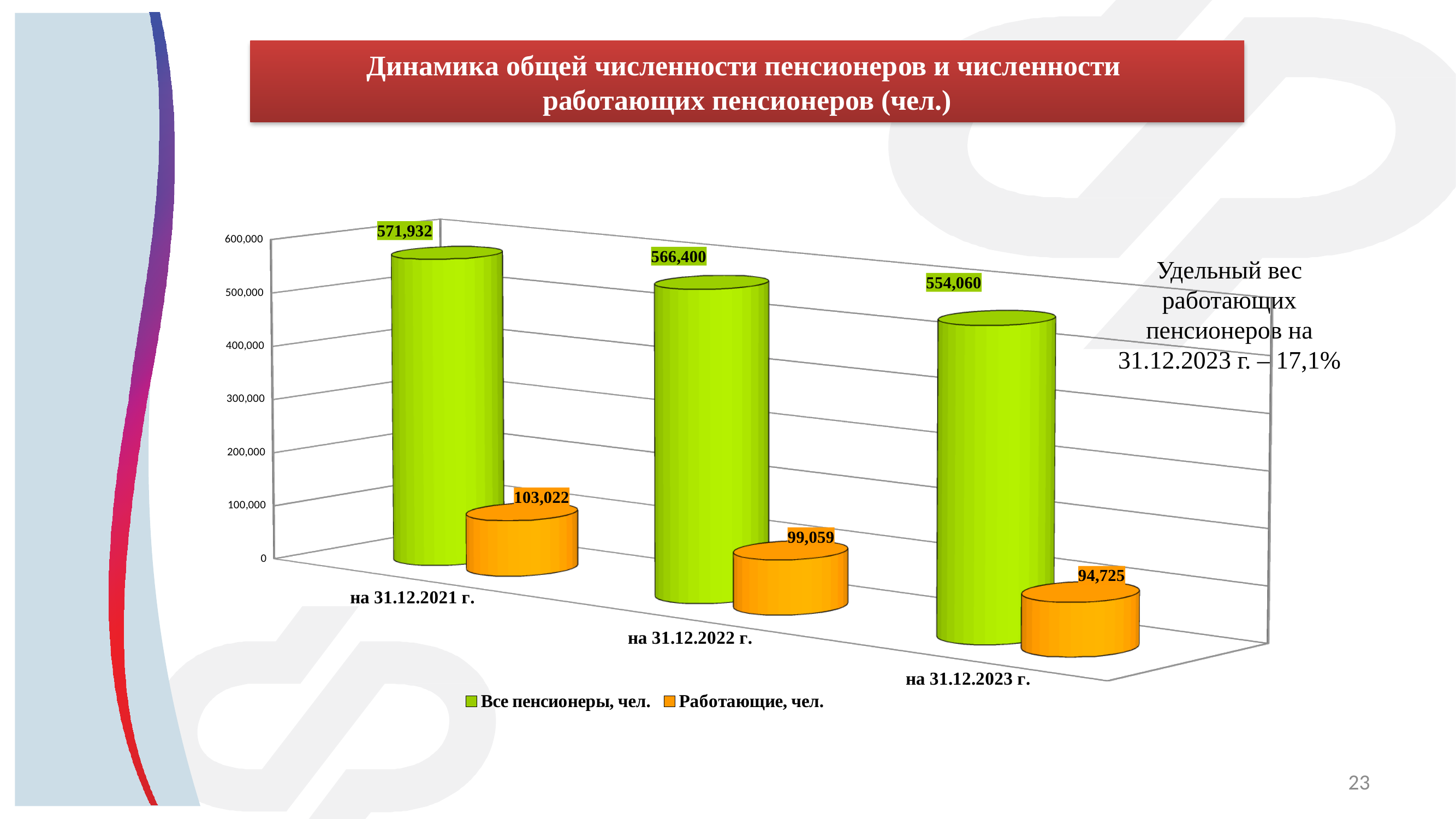
Do the values for 'Все пенсионеры, чел.' rise or fall from 31.12.2021 to 31.12.2023? fall What is the value for 'Все пенсионеры, чел.' on 31.12.2022? 566,400 What is the difference between 'Работающие, чел.' on 31.12.2021 and on 31.12.2022? 3,963 What is the value for 'Работающие, чел.' on 31.12.2023? 94,725 How many series does the legend list? 2 In which period is the value for 'Все пенсионеры, чел.' the highest? на 31.12.2021 г. What kind of chart is shown on the slide? bar chart Which is larger: 'Работающие, чел.' on 31.12.2022 or on 31.12.2023? на 31.12.2022 г. How many time periods are shown on the x axis? 3 What is the difference between 'Все пенсионеры, чел.' on 31.12.2021 and on 31.12.2023? 17,872 In which period is the value for 'Работающие, чел.' the lowest? на 31.12.2023 г. What is the value for 'Все пенсионеры, чел.' on 31.12.2021? 571,932